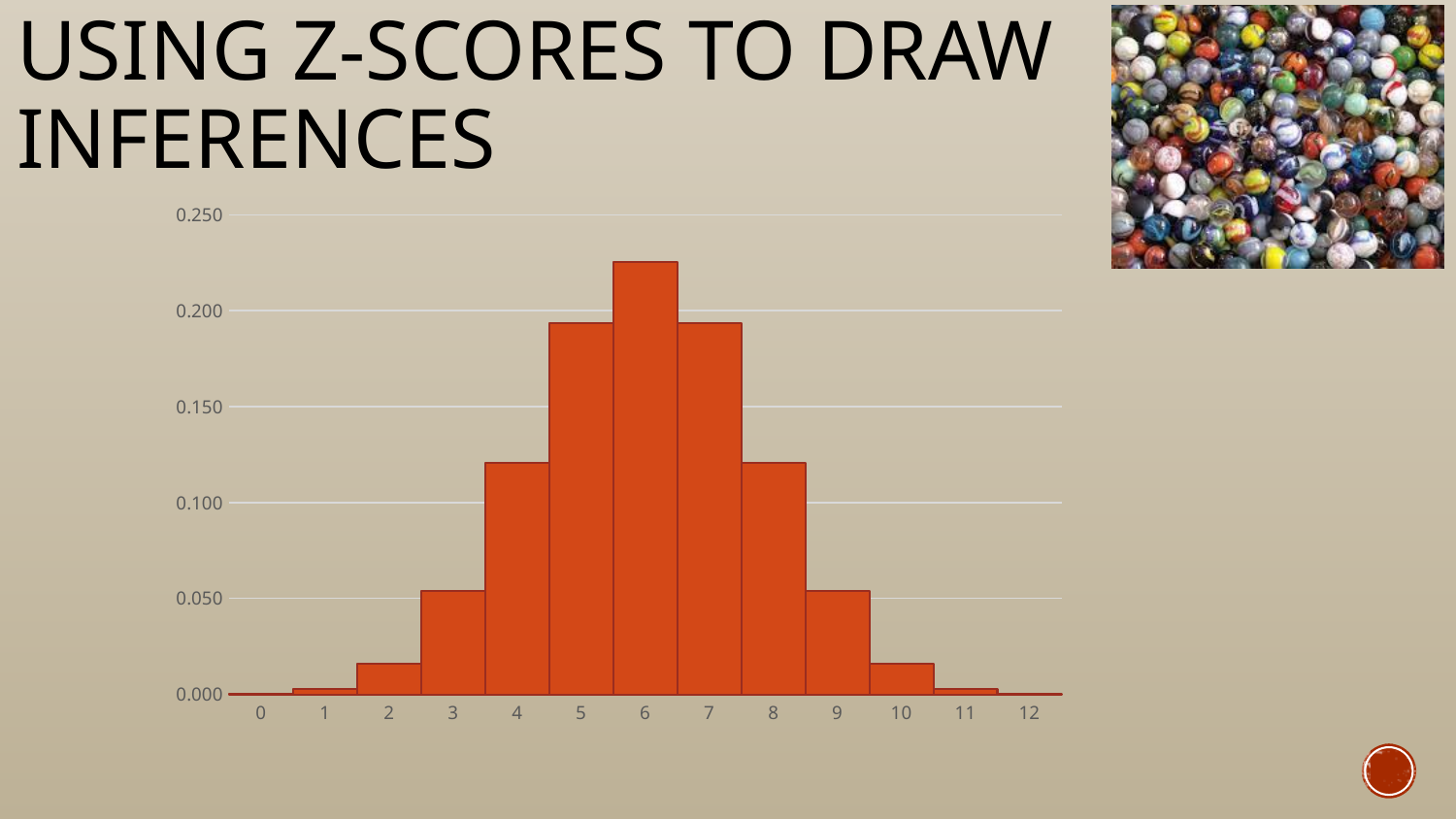
Is the value for category 5 greater or less than 0.150? greater Is the value for category 8 greater or less than 0.100? greater How many categories are shown along the x axis of the chart? 13 What is the title of the slide containing the chart? USING Z-SCORES TO DRAW INFERENCES Do the bar values rise or fall as the x axis goes from 0 to 6? rise What kind of chart is shown on the slide? bar chart Is the value for category 6 greater or less than 0.200? greater Which category has the highest bar in the chart? 6 Do the bar values rise or fall as the x axis goes from 6 to 12? fall Which is larger, the value for category 4 or the value for category 3? 4